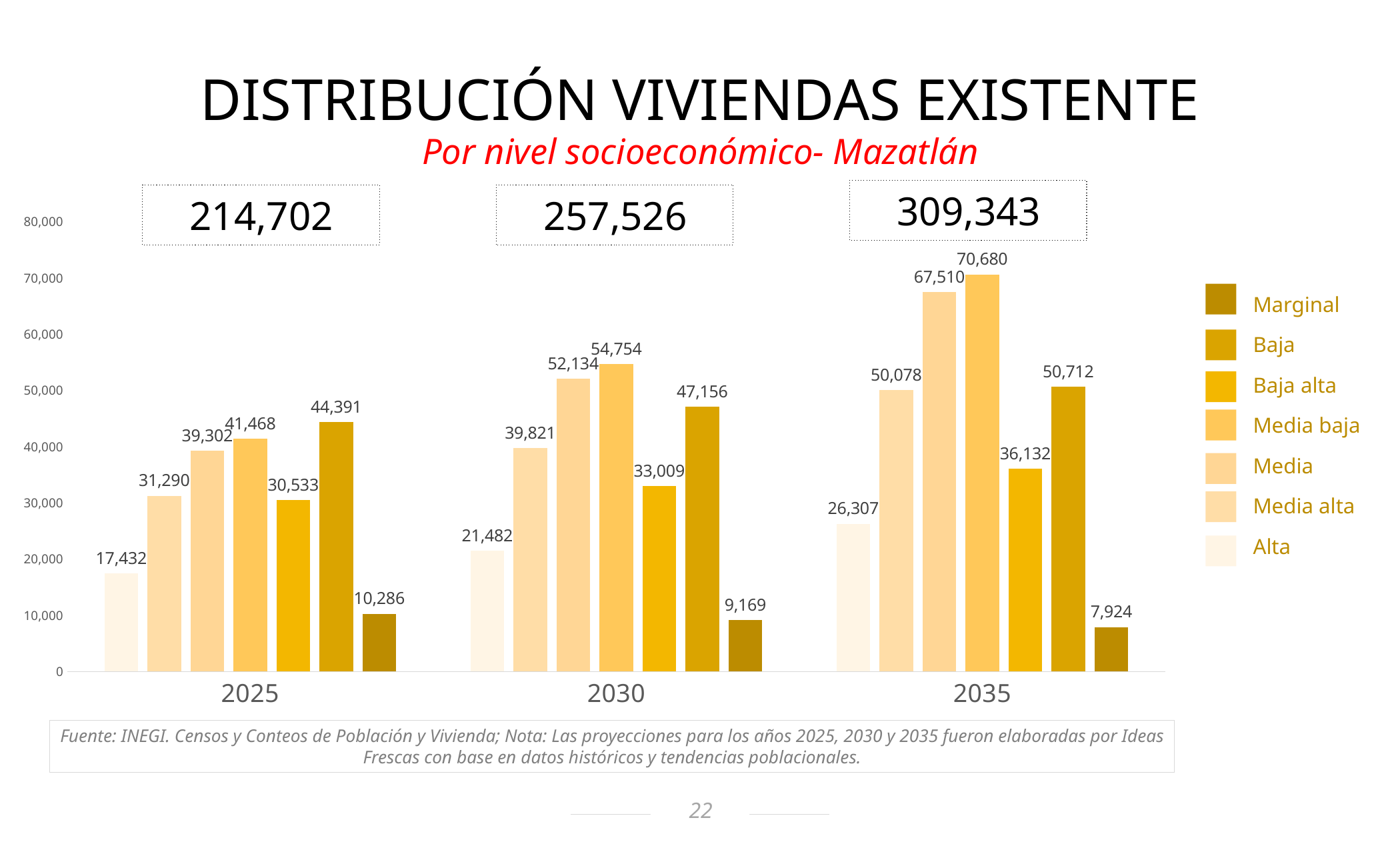
What is the value for Marginal in 2025? 10,286 What total is shown above the 2035 group? 309,343 Which socioeconomic level has the highest value in 2030? Media baja What kind of chart is shown on the slide? bar chart Which socioeconomic level has the lowest value in 2035? Marginal How many year groups are shown on the x axis? 3 What is the difference between the Baja value and the Baja alta value in 2025? 13,858 What is the value for Media baja in 2035? 70,680 What is the value for Alta in 2030? 21,482 How many series does the legend list? 7 Which is larger in 2030, Media or Baja? Media Does the value for Marginal rise or fall from 2025 to 2035? fall